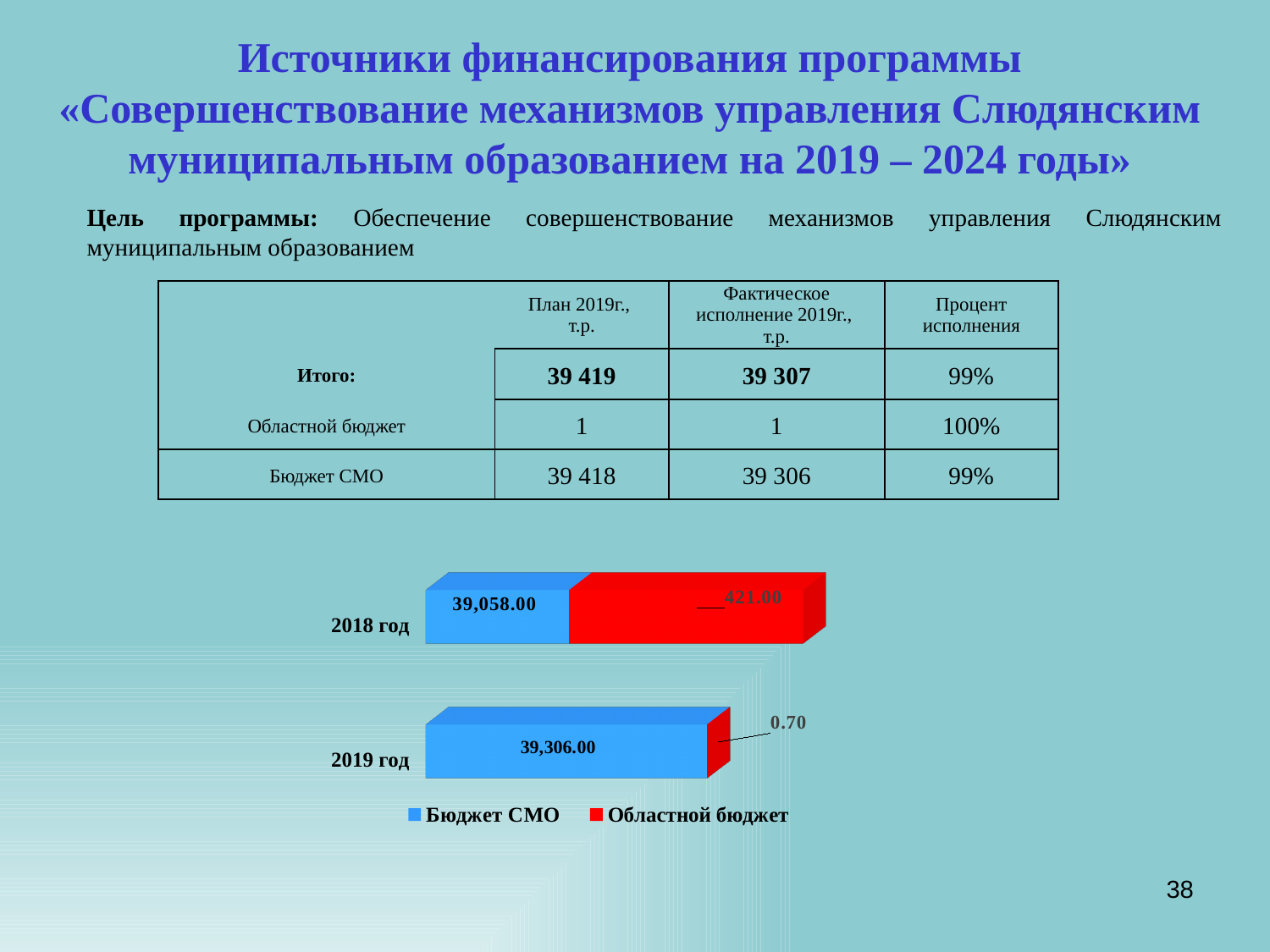
Is the Областной бюджет value larger for 2018 год or for 2019 год in the chart? 2018 год By how much does the Бюджет СМО value for 2019 год exceed that for 2018 год in the chart? 248.00 How many series does the chart legend list? 2 Which year has the higher value for Бюджет СМО in the chart? 2019 год What is the value of Областной бюджет for 2019 год in the chart? 0.70 What is the value of Областной бюджет for 2018 год in the chart? 421.00 What type of chart is shown on the slide? Bar chart What is the difference between the Областной бюджет values for 2018 год and 2019 год in the chart? 420.30 What is the value of Бюджет СМО for 2018 год in the chart? 39,058.00 What is the value of Бюджет СМО for 2019 год in the chart? 39,306.00 What is the total of the stacked bar for 2018 год in the chart? 39,479.00 Which year has the lower value for Областной бюджет in the chart? 2019 год